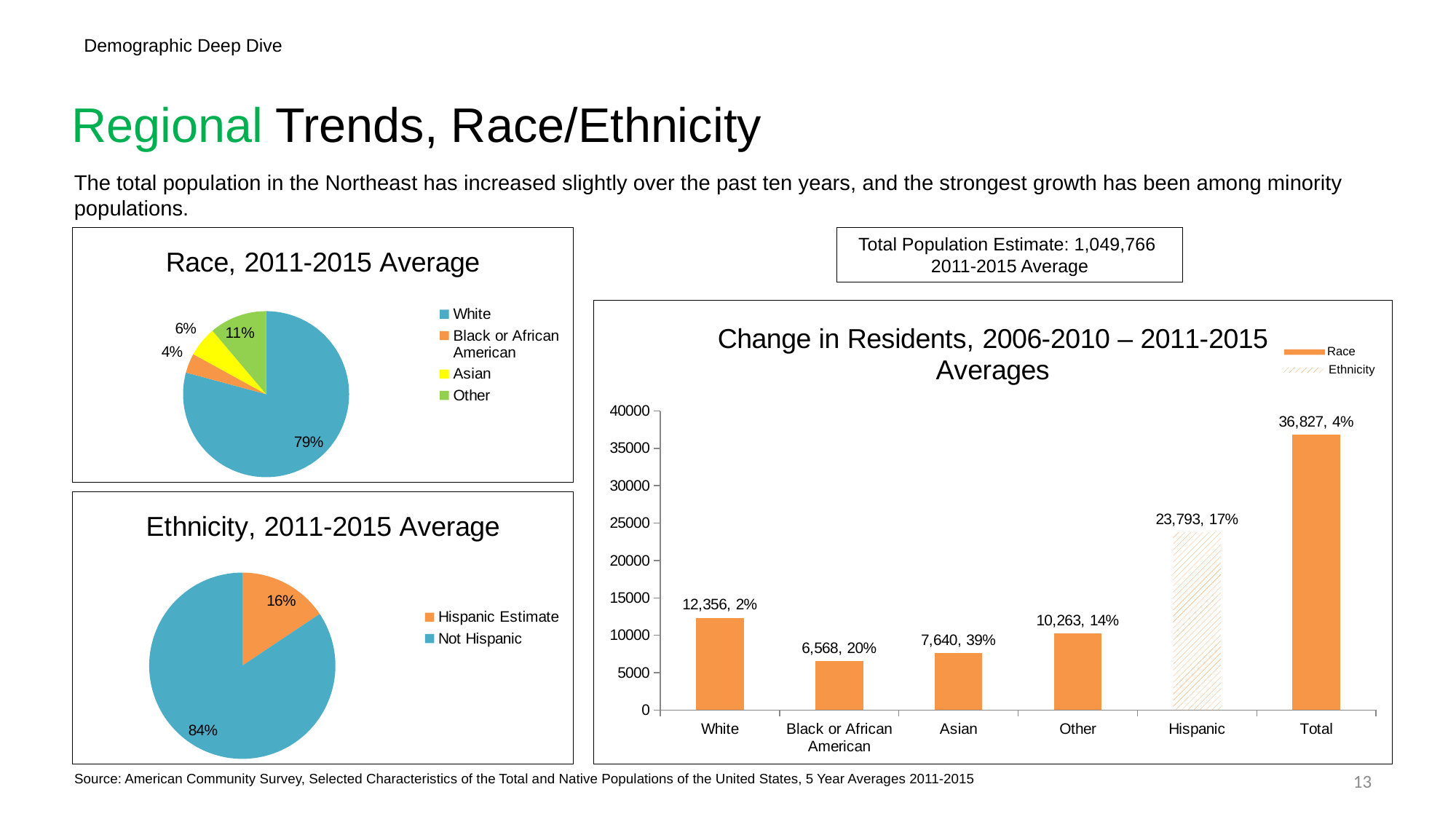
In the 'Race, 2011-2015 Average' pie chart, which category has the smallest slice? Black or African American In the 'Change in Residents, 2006-2010 – 2011-2015 Averages' chart, what is the value for Hispanic? 23,793 In the 'Race, 2011-2015 Average' pie chart, what share does Asian have? 6% In the 'Change in Residents, 2006-2010 – 2011-2015 Averages' chart, which category has the lowest value? Black or African American In the 'Race, 2011-2015 Average' pie chart, what share does White have? 79% In the 'Change in Residents, 2006-2010 – 2011-2015 Averages' chart, what is the value for Black or African American? 6,568 In the 'Ethnicity, 2011-2015 Average' pie chart, what share does Hispanic Estimate have? 16% What kind of chart is 'Ethnicity, 2011-2015 Average'? Pie chart In the 'Change in Residents, 2006-2010 – 2011-2015 Averages' chart, how many series does the legend list? 2 In the 'Race, 2011-2015 Average' pie chart, how many categories does the legend list? 4 In the 'Change in Residents, 2006-2010 – 2011-2015 Averages' chart, which is larger, the value for Asian or the value for Other? Other In the 'Change in Residents, 2006-2010 – 2011-2015 Averages' chart, what is the difference between the values for White and Other? 2,093